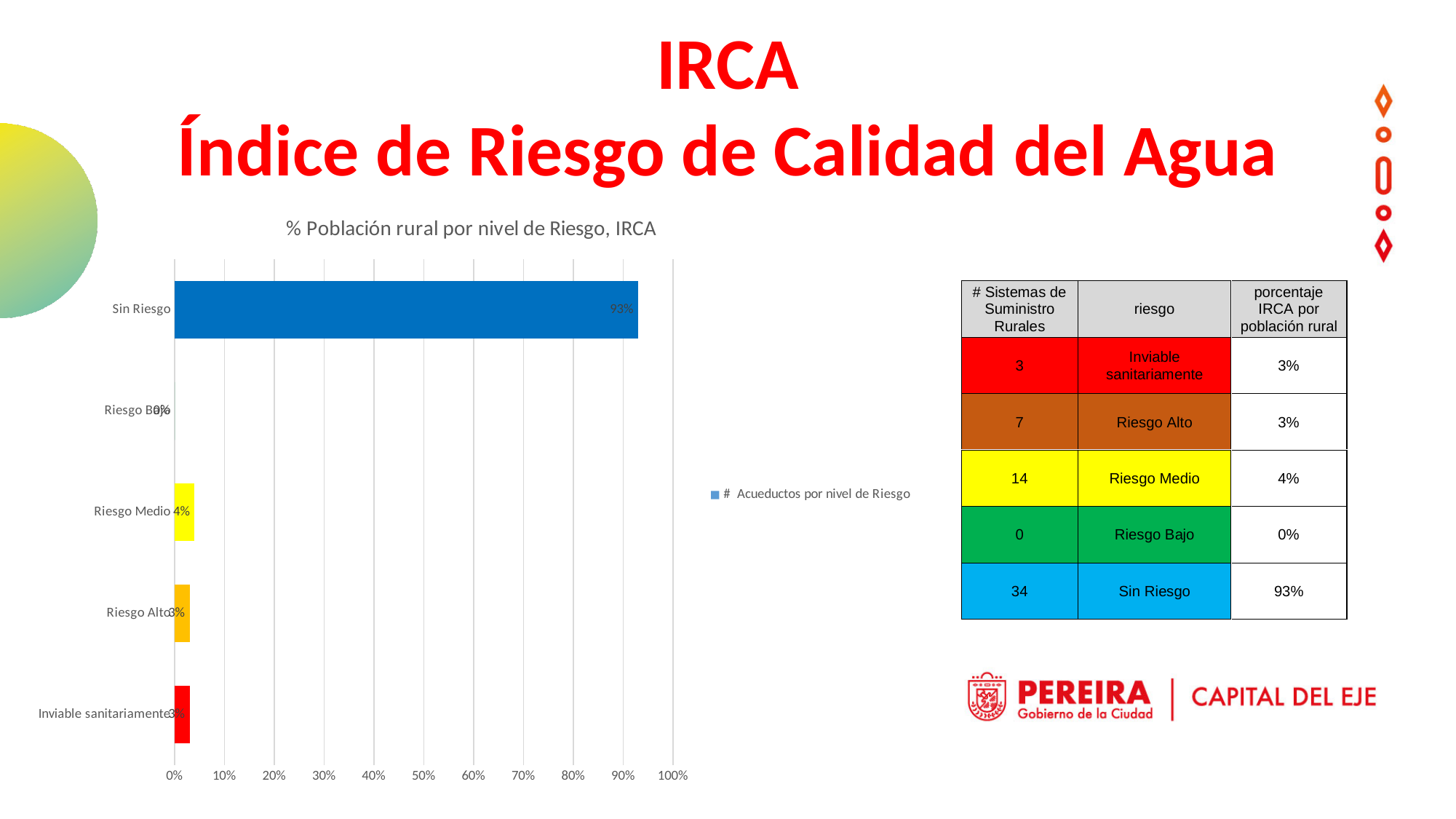
Which is larger, the value for Riesgo Medio or the value for Riesgo Alto? Riesgo Medio How many categories are shown in the chart? 5 What entry does the chart legend list? # Acueductos por nivel de Riesgo What is the value for Riesgo Bajo in the chart? 0% What is the title of the chart? % Población rural por nivel de Riesgo, IRCA What type of chart is shown on the slide? Bar chart What is the value for Sin Riesgo in the chart? 93% Which category has the lowest value in the chart? Riesgo Bajo What is the value for Riesgo Medio in the chart? 4% Which category has the highest value in the chart? Sin Riesgo What is the value for Riesgo Alto in the chart? 3% What is the difference between the values for Sin Riesgo and Riesgo Medio? 89%